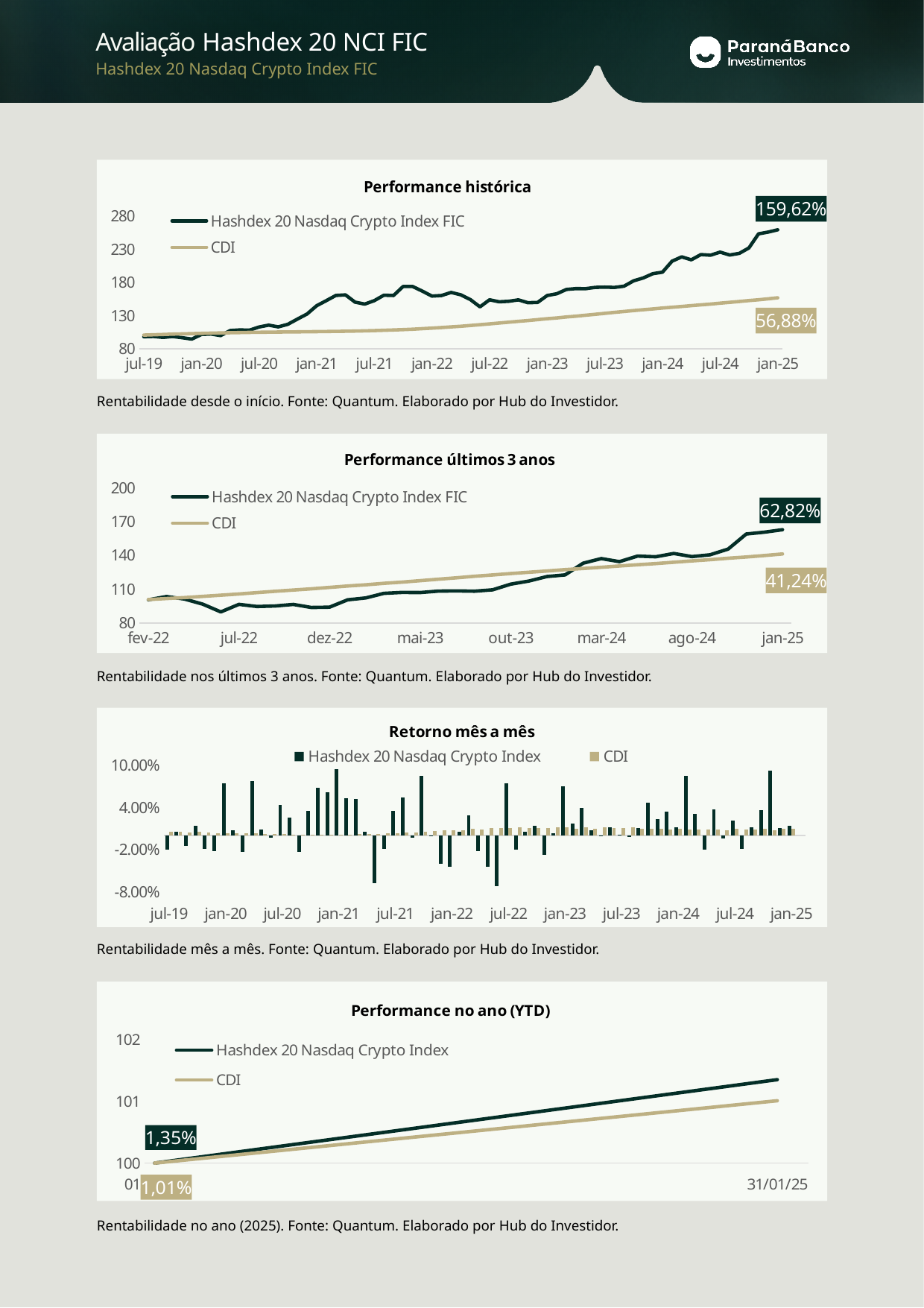
What kind of chart is 'Performance histórica'? Line chart In the 'Performance no ano (YTD)' chart, do the lines rise or fall from 01/01/25 to 31/01/25? Rise How many series does the legend of the 'Performance últimos 3 anos' chart list? 2 In the 'Performance histórica' chart, what is the final value labelled for the CDI line? 56,88% In the 'Performance no ano (YTD)' chart, what is the value labelled for CDI? 1,01% What kind of chart is 'Retorno mês a mês'? Bar chart In the 'Performance histórica' chart, what is the final value labelled for the Hashdex 20 Nasdaq Crypto Index FIC line? 159,62% In the 'Performance histórica' chart, what is the difference between the labelled final values of the Hashdex 20 Nasdaq Crypto Index FIC and CDI? 102,74 percentage points In the 'Performance últimos 3 anos' chart, what is the final value labelled for the Hashdex 20 Nasdaq Crypto Index FIC line? 62,82% In the 'Performance no ano (YTD)' chart, what is the value labelled for the Hashdex 20 Nasdaq Crypto Index? 1,35% In the 'Performance últimos 3 anos' chart, what is the final value labelled for the CDI line? 41,24% In the 'Performance últimos 3 anos' chart, what is the difference between the labelled final values of the Hashdex 20 Nasdaq Crypto Index FIC and CDI? 21,58 percentage points